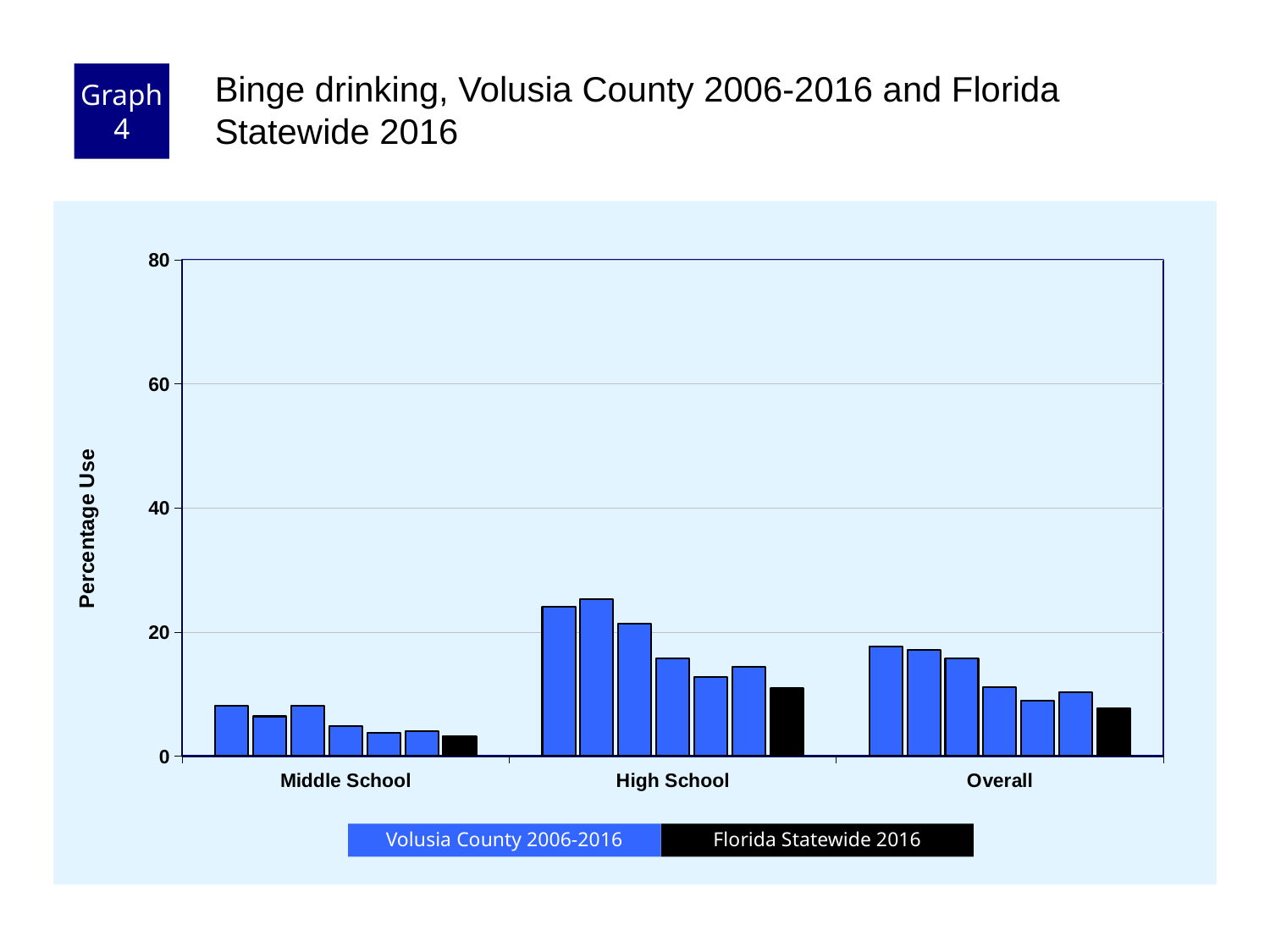
How many categories are shown on the x axis? 3 What is the label on the y axis? Percentage Use Which category has the highest binge drinking percentages? High School What kind of chart is shown on the slide? Bar chart Is the Florida Statewide 2016 value for Middle School greater or less than 20? less Which is larger, the Florida Statewide 2016 value for High School or for Middle School? High School Is the tallest Volusia County bar for High School greater or less than 40? less Is the Florida Statewide 2016 value for High School greater or less than 20? less Do the Volusia County bars for Overall generally rise or fall from left to right? fall Which category has the lowest binge drinking percentages? Middle School How many series does the legend list? 2